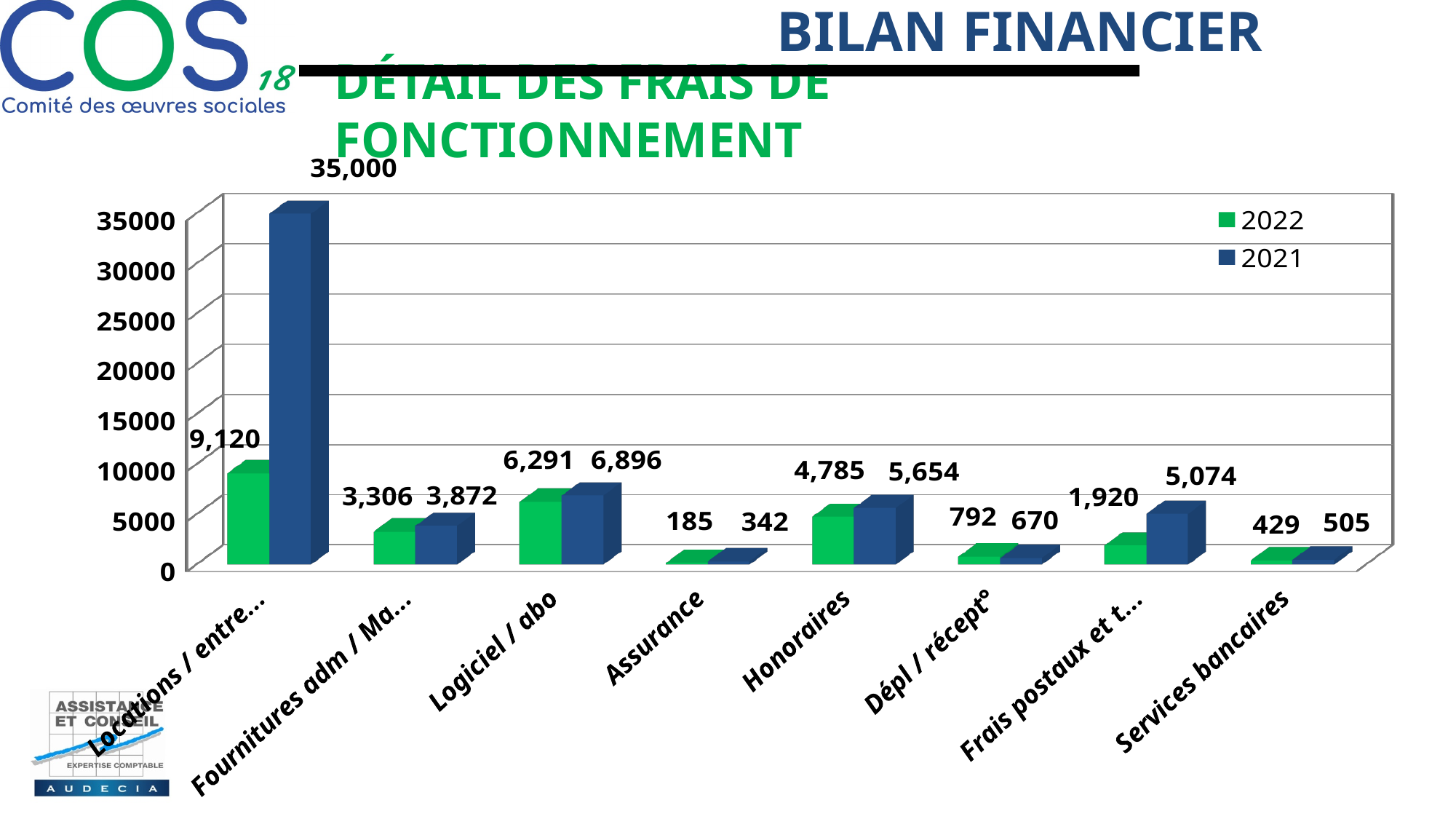
What is the 2022 value for Logiciel / abo? 6,291 Which category has the lowest 2021 value? Assurance What is the difference between the 2021 and 2022 values for Honoraires? 869 What is the 2022 value for Assurance? 185 How many series does the legend list? 2 What is the difference between the 2021 and 2022 values for Logiciel / abo? 605 Which category has the lowest 2022 value? Assurance For Dépl / récept°, which year has the larger value, 2022 or 2021? 2022 How many categories are shown on the x axis? 8 What kind of chart is shown on the slide? Bar chart What is the 2021 value for Services bancaires? 505 What is the 2021 value for Honoraires? 5,654